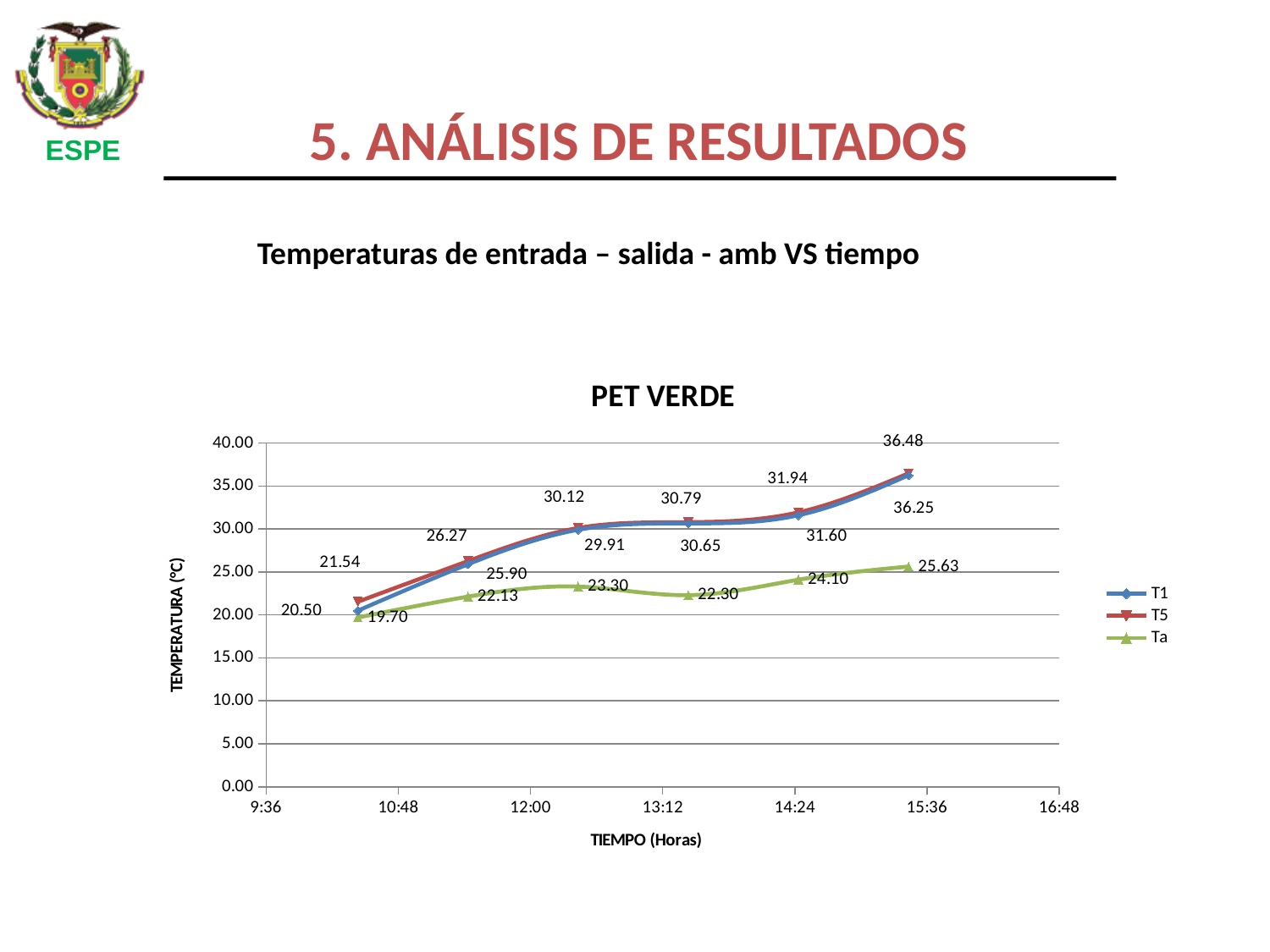
What is the value of the first T1 data point in the PET VERDE chart? 20.50 What is the highest value labelled for the T5 series in the PET VERDE chart? 36.48 Which series reaches the highest value in the PET VERDE chart? T5 At the last data point of the PET VERDE chart, which series is higher, T1 or T5? T5 What is the lowest value labelled for the Ta series in the PET VERDE chart? 19.70 What type of chart is shown under the title PET VERDE? line chart By how much does the Ta series increase from its first value (19.70) to its last value (25.63) in the PET VERDE chart? 5.93 Does the T1 series in the PET VERDE chart generally rise or fall over time? rise What is the title of the vertical axis in the PET VERDE chart? TEMPERATURA (°C) How many data points are plotted for the T5 series in the PET VERDE chart? 6 What is the difference between the final T5 value (36.48) and the final T1 value (36.25) in the PET VERDE chart? 0.23 How many series does the legend of the PET VERDE chart list? 3